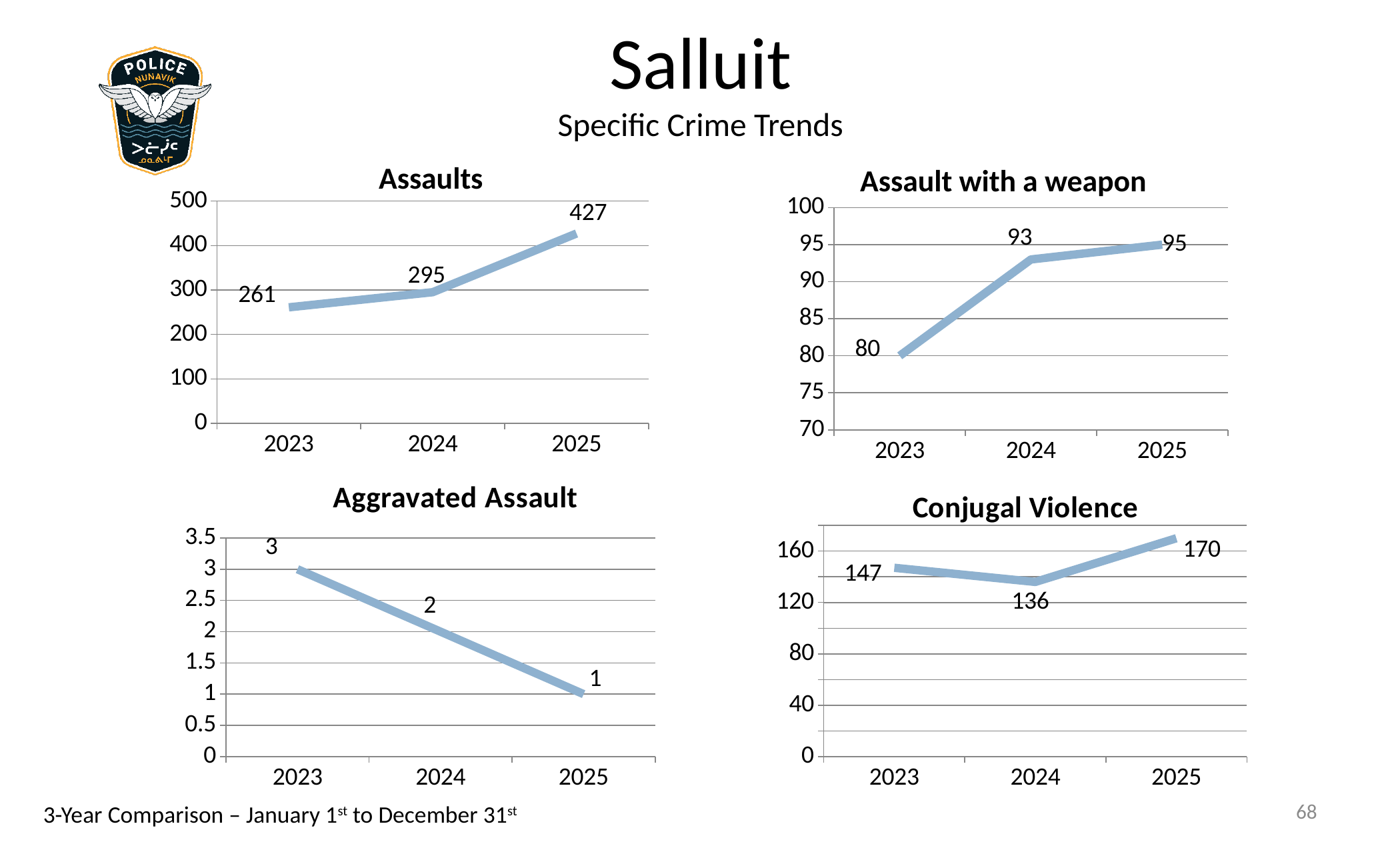
In the Assaults chart, what is the difference between the 2025 and 2023 values? 166 In the Assault with a weapon chart, which year has the lowest value? 2023 In the Conjugal Violence chart, what is the value for 2024? 136 In the Conjugal Violence chart, which is larger, the value for 2023 or the value for 2024? 2023 In the Aggravated Assault chart, do the values rise or fall from 2023 to 2025? fall What kind of chart is the Assaults chart? line chart In the Conjugal Violence chart, what is the difference between the 2025 and 2024 values? 34 In the Assaults chart, what is the value for 2025? 427 How many years are plotted in the Assault with a weapon chart? 3 In the Aggravated Assault chart, what is the value for 2023? 3 In the Conjugal Violence chart, which year has the highest value? 2025 In the Assault with a weapon chart, what is the value for 2024? 93